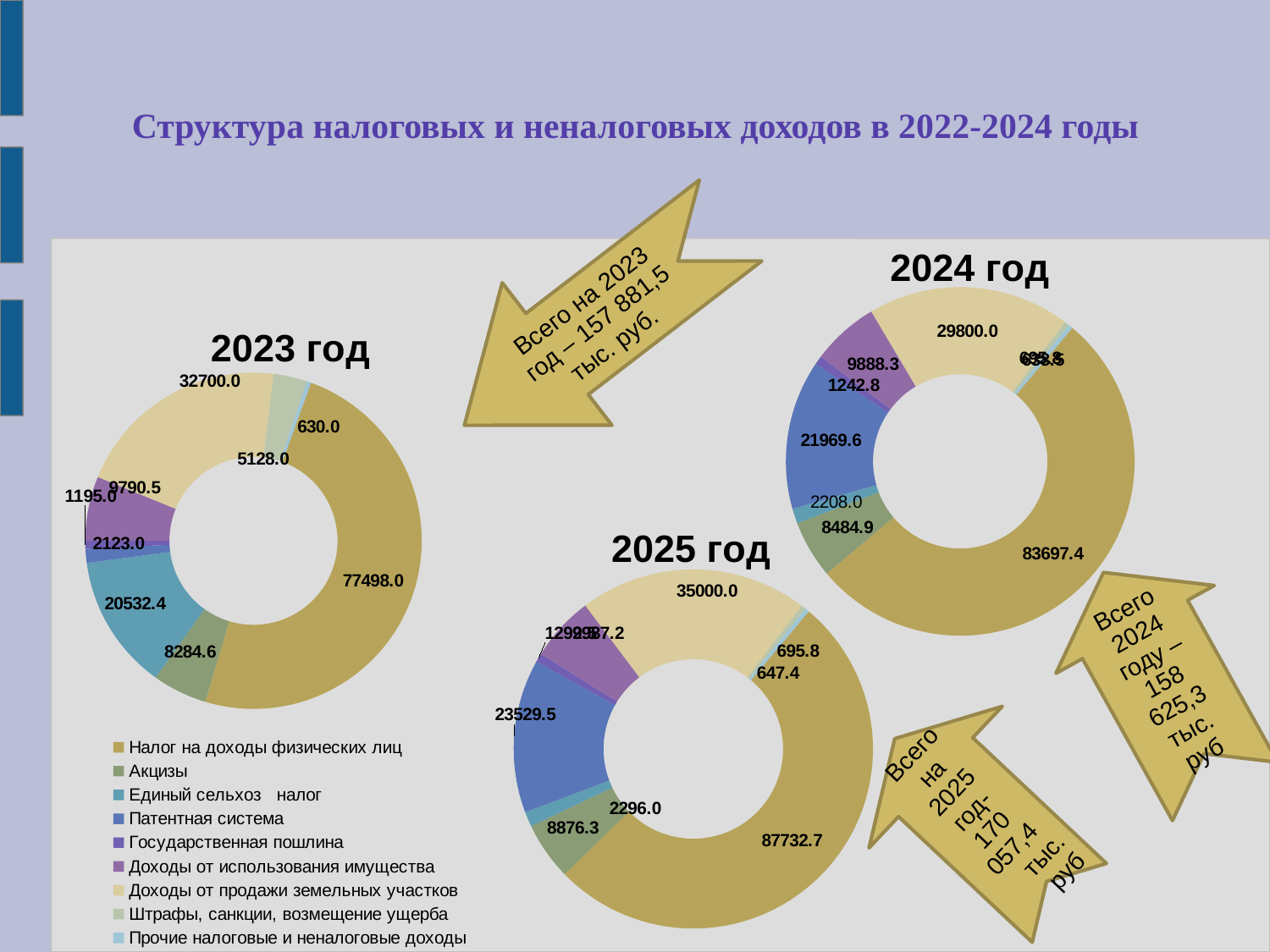
In the 2023 год chart, which is larger: Единый сельхоз налог or Акцизы? Единый сельхоз налог In the 2025 год chart, which category has the largest value? Налог на доходы физических лиц In the 2024 год chart, what is the value for Доходы от продажи земельных участков? 29800.0 What is the difference between the Доходы от продажи земельных участков value in the 2025 год chart and in the 2024 год chart? 5200.0 In the 2023 год chart, what is the value for Штрафы, санкции, возмещение ущерба? 5128.0 In the 2024 год chart, what is the value for Акцизы? 8484.9 How many series does the legend list? 9 What is the difference between the Налог на доходы физических лиц value in the 2024 год chart and in the 2023 год chart? 6199.4 In the 2023 год chart, what is the value for Налог на доходы физических лиц? 77498.0 What is the title of the slide? Структура налоговых и неналоговых доходов в 2022-2024 годы What kind of chart is used for the 2023 год, 2024 год and 2025 год charts? pie chart (doughnut)